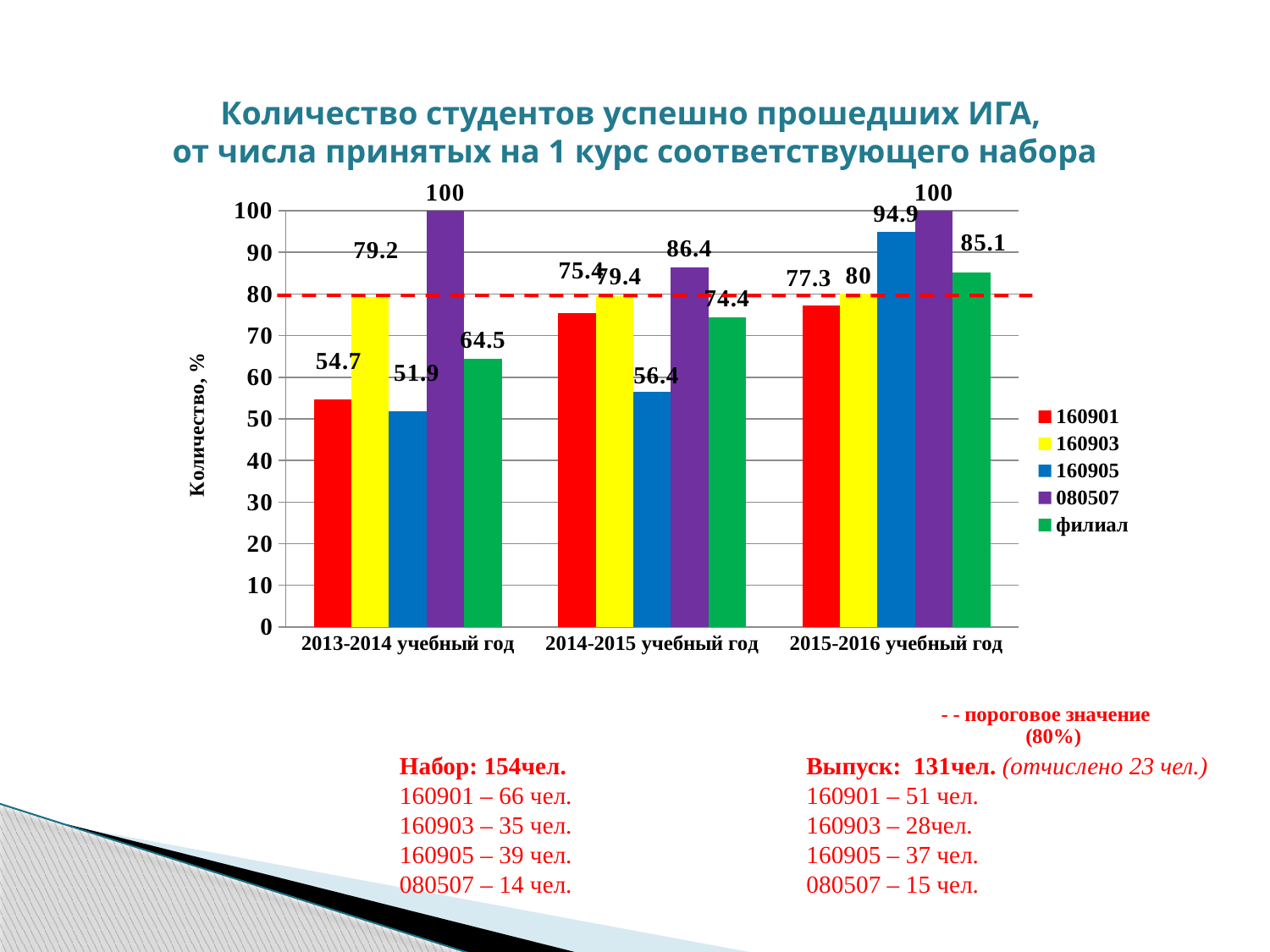
Which is larger: the value for 160901 in 2015-2016 учебный год or the value for 160903 in 2015-2016 учебный год? 160903 What type of chart is shown on the slide? bar chart What is the value for series 160905 in 2015-2016 учебный год? 94.9 What value does the red dashed threshold line (пороговое значение) mark on the chart? 80% Which series has the lowest value in 2013-2014 учебный год? 160905 What is the value for филиал in 2014-2015 учебный год? 74.4 What is the value for series 160901 in 2013-2014 учебный год? 54.7 How many academic years (categories) are shown on the x axis? 3 What is the difference between the values for 160905 in 2015-2016 учебный год and 2014-2015 учебный год? 38.5 Does the value for series 160901 rise or fall from 2013-2014 to 2015-2016 учебный год? rise How many series does the legend list? 5 Which series has the highest value in 2014-2015 учебный год? 080507